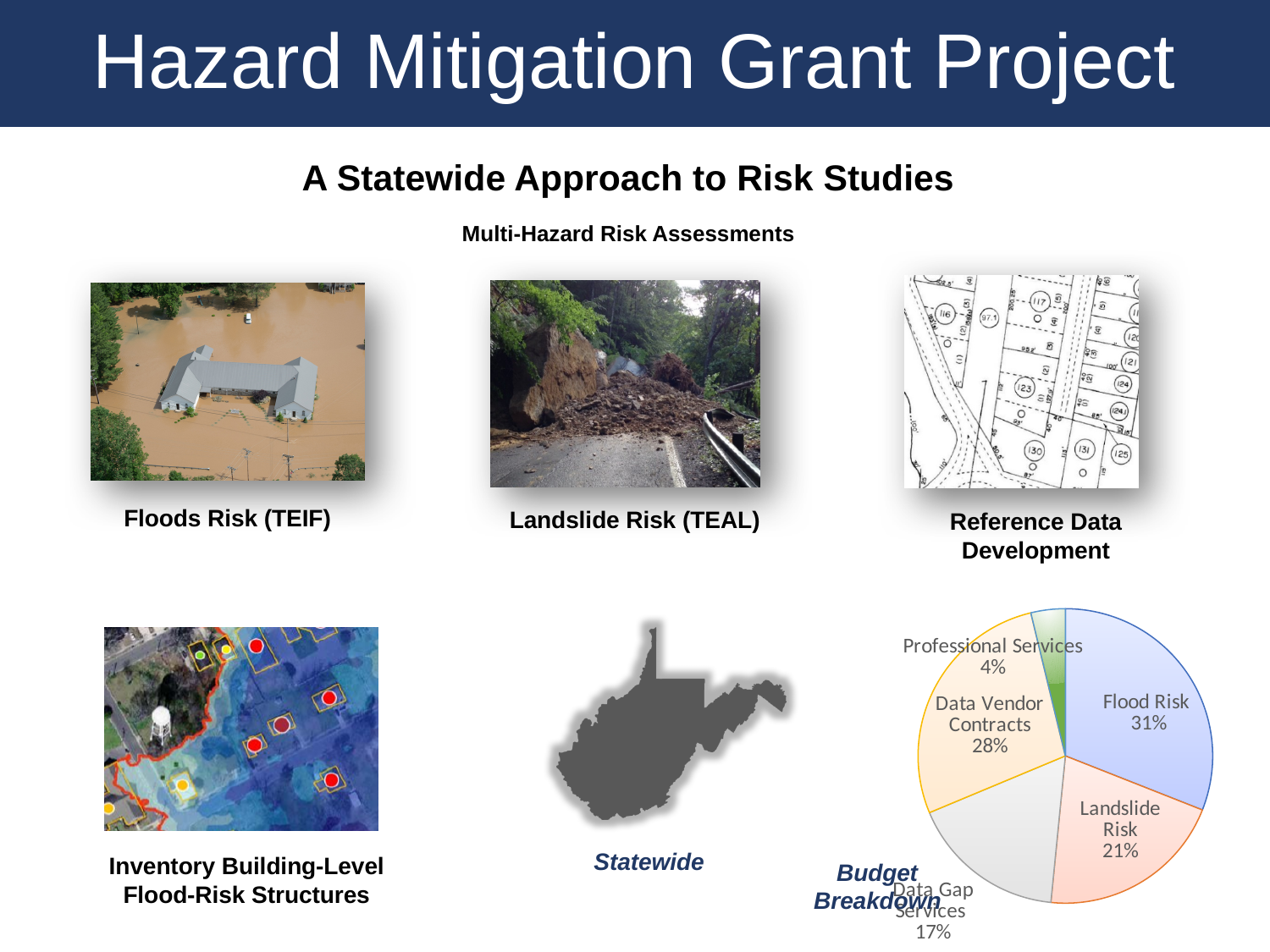
What is the title of the pie chart on the slide? Budget Breakdown In the Budget Breakdown pie chart, what share do Professional Services have? 4% In the Budget Breakdown pie chart, what share do Data Vendor Contracts have? 28% In the Budget Breakdown pie chart, which labelled category has the smallest share? Professional Services In the Budget Breakdown pie chart, how many percentage points larger is Data Vendor Contracts than Professional Services? 24 In the Budget Breakdown pie chart, which labelled category has the largest share? Flood Risk In the Budget Breakdown pie chart, what share does Flood Risk have? 31% In the Budget Breakdown pie chart, which is larger: Data Vendor Contracts or Data Gap Services? Data Vendor Contracts In the Budget Breakdown pie chart, what share does Landslide Risk have? 21% In the Budget Breakdown pie chart, how many percentage points larger is Flood Risk than Landslide Risk? 10 What kind of chart is the Budget Breakdown chart? pie chart In the Budget Breakdown pie chart, what share do Data Gap Services have? 17%